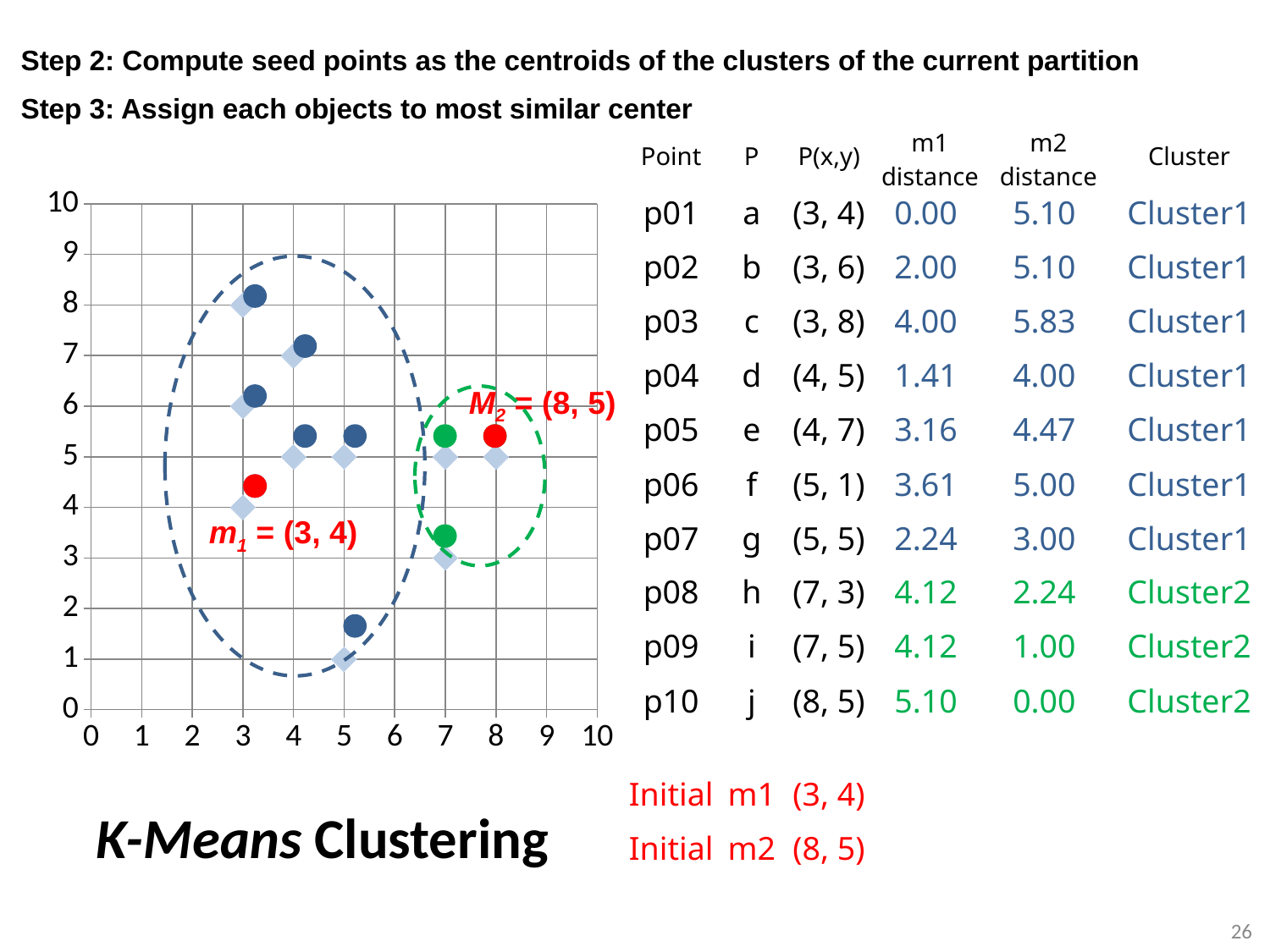
What are the coordinates of the centroid labelled M2 on the chart? (8, 5) For point g (5, 5), which is larger: the m1 distance or the m2 distance? m2 distance How many points are assigned to Cluster2? 3 What is the m1 distance for point h (7, 3)? 4.12 How many points are assigned to Cluster1? 7 What is the highest value shown on the chart's y axis? 10 Which point has the largest x coordinate on the chart? j (8, 5) Which point has the lowest y coordinate on the chart? f (5, 1) What is the difference between the m2 distance and the m1 distance for point c (3, 8)? 1.83 What kind of chart is shown on the left of the slide? scatter chart How many data points (p01 to p10) are plotted on the chart? 10 What are the coordinates of the centroid labelled m1 on the chart? (3, 4)